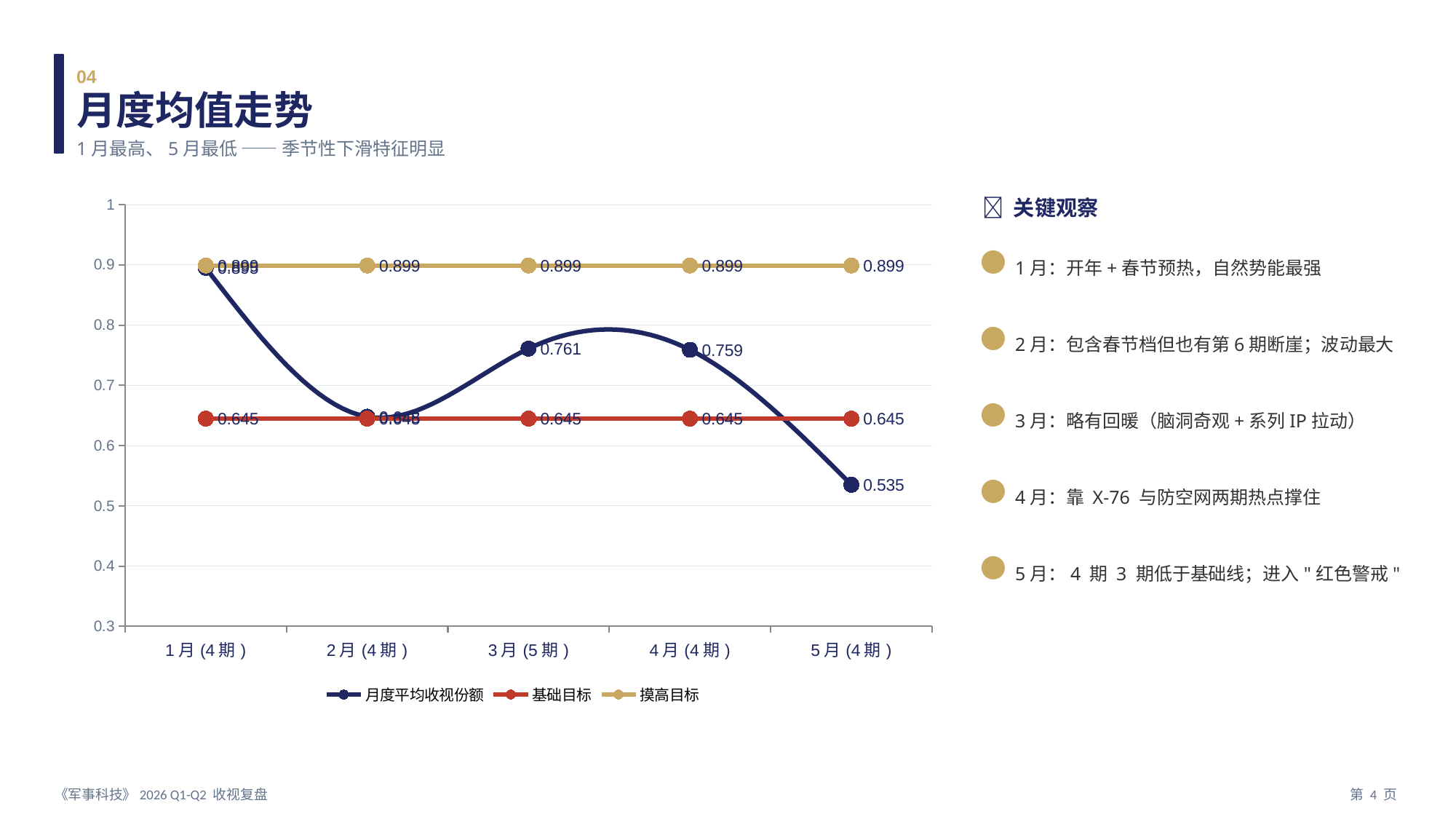
What kind of chart is shown on the slide? line chart What value does the 摸高目标 line hold across all months? 0.899 What value does the 基础目标 line hold across all months? 0.645 Which is larger, the 月度平均收视份额 for 4月 (4期) or for 5月 (4期)? 4月 (4期) Does the 月度平均收视份额 line rise or fall from 3月 (5期) to 5月 (4期)? fall What is the 月度平均收视份额 value for 3月 (5期)? 0.761 What is the difference between the 月度平均收视份额 for 4月 (4期) and 5月 (4期)? 0.224 Which month has the lowest 月度平均收视份额? 5月 (4期) How many months are plotted along the x axis of the chart? 5 Is the 月度平均收视份额 value for 1月 (4期) greater or less than 0.8? greater What is the 月度平均收视份额 value for 5月 (4期)? 0.535 How many series does the chart legend list? 3